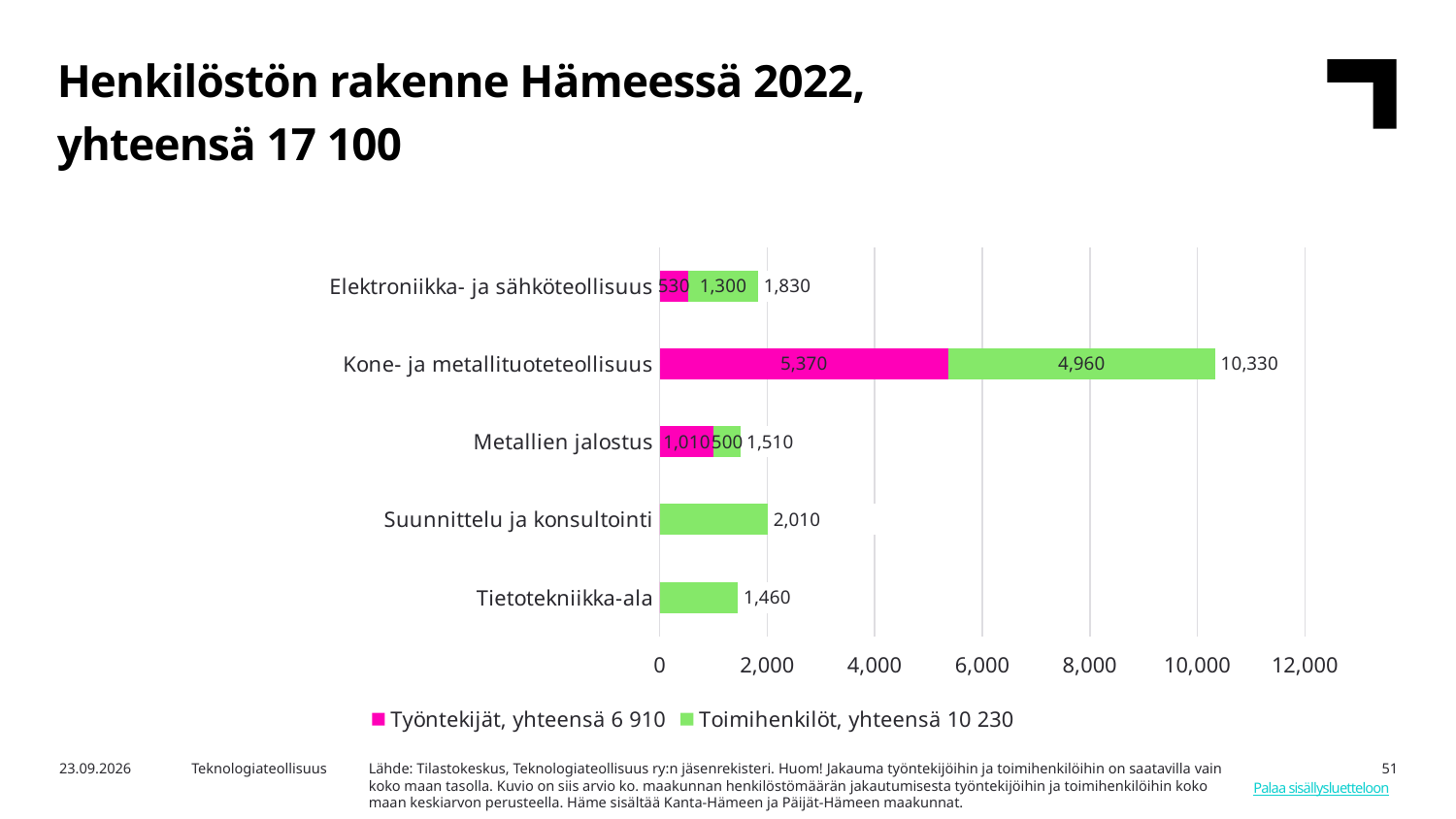
Which category has the highest total? Kone- ja metallituoteteollisuus Which is larger: the total for Suunnittelu ja konsultointi or the total for Elektroniikka- ja sähköteollisuus? Suunnittelu ja konsultointi What is the total value shown for Metallien jalostus? 1,510 What is the Toimihenkilöt value for Elektroniikka- ja sähköteollisuus? 1,300 Which category has the lowest total? Tietotekniikka-ala What is the title of the chart? Henkilöstön rakenne Hämeessä 2022, yhteensä 17 100 What type of chart is shown on the slide? Stacked bar chart How many series does the legend list? 2 Is the total for Kone- ja metallituoteteollisuus greater or less than 10,000? greater What is the Työntekijät value for Kone- ja metallituoteteollisuus? 5,370 What is the difference between the Työntekijät and Toimihenkilöt values for Kone- ja metallituoteteollisuus? 410 How many categories are shown on the chart? 5